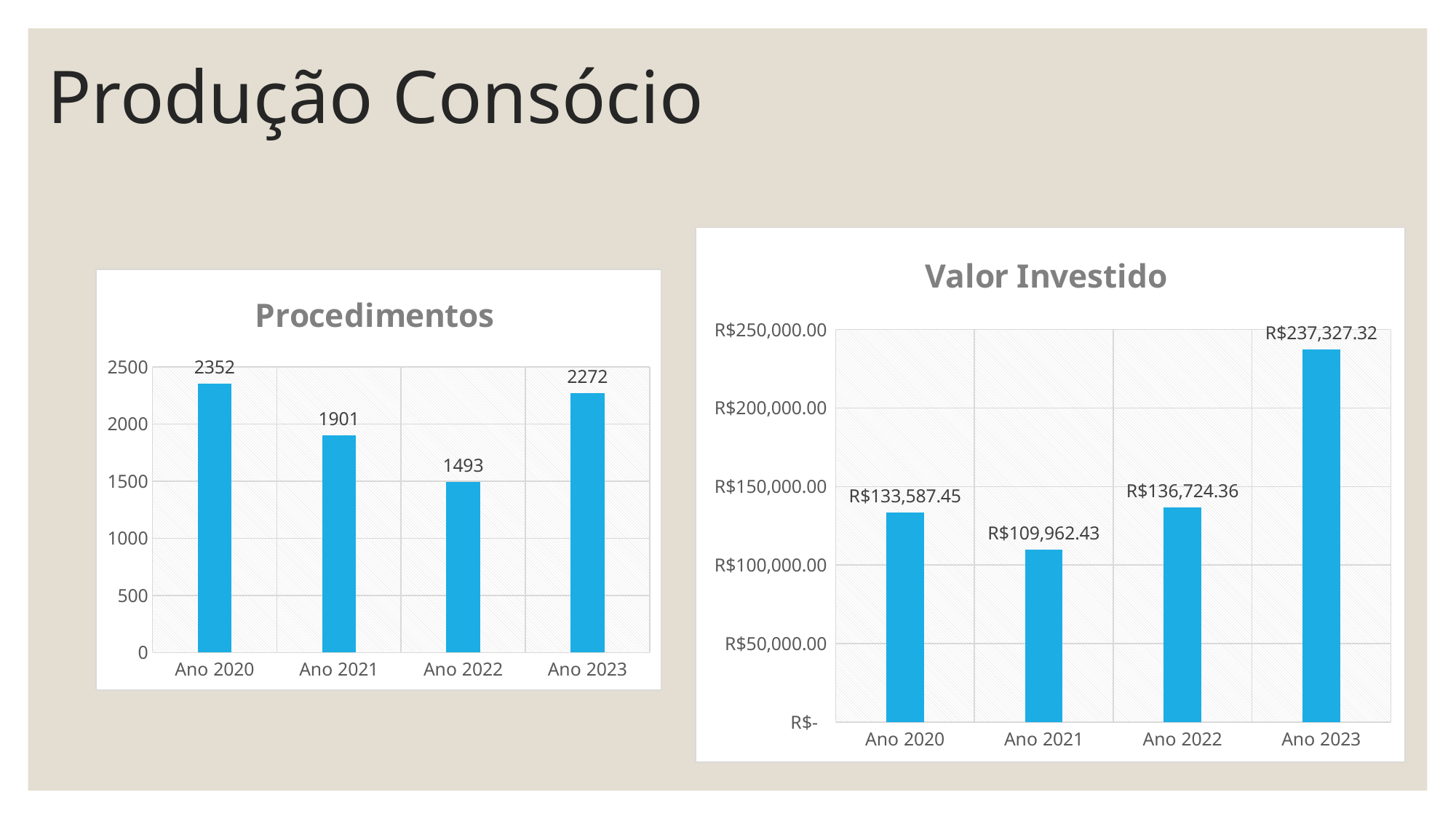
What kind of chart is the Valor Investido chart? bar chart In the Procedimentos chart, is the value for Ano 2022 greater or less than 1500? less In the Procedimentos chart, what is the difference between Ano 2020 and Ano 2023? 80 In the Procedimentos chart, what is the value for Ano 2021? 1901 In the Valor Investido chart, what is the value for Ano 2022? R$136,724.36 What is the title of the chart on the left of the slide? Procedimentos In the Procedimentos chart, which year has the lowest value? Ano 2022 In the Valor Investido chart, which year has the highest value? Ano 2023 In the Valor Investido chart, which year has the lowest value? Ano 2021 In the Procedimentos chart, which year has the highest value? Ano 2020 In the Valor Investido chart, which is larger, Ano 2020 or Ano 2022? Ano 2022 In the Procedimentos chart, how many years are shown? 4